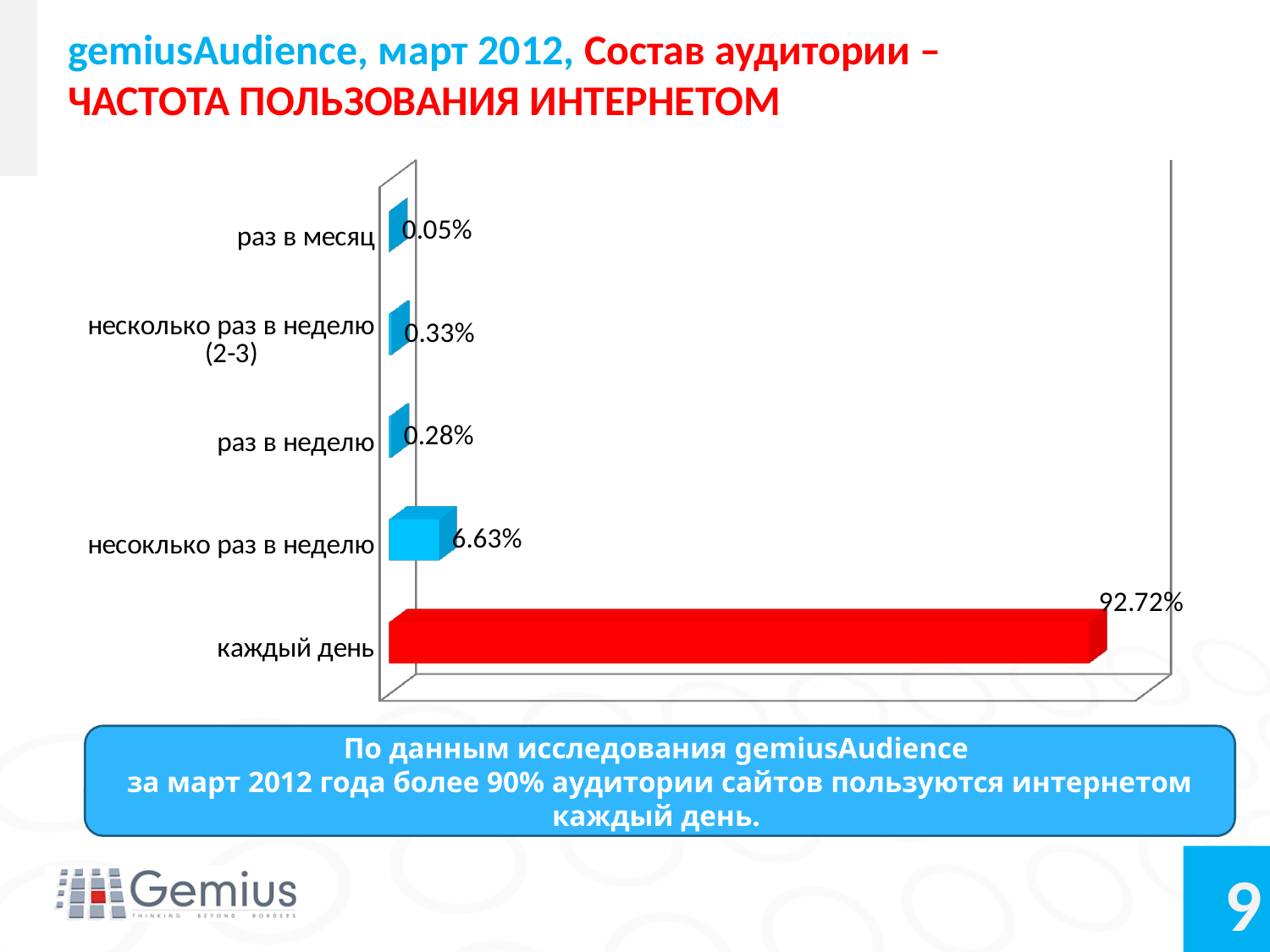
Which category has the lowest value? раз в месяц What is the value for "несоколько раз в неделю"? 6.63% What is the value for "раз в неделю"? 0.28% What is the value for "раз в месяц"? 0.05% Which is larger, the value for "несколько раз в неделю (2-3)" or the value for "раз в неделю"? несколько раз в неделю (2-3) What is the difference between the values for "каждый день" and "несоколько раз в неделю"? 86.09% How many categories are shown in the chart? 5 What colour is the bar for "каждый день"? red What kind of chart is shown on the slide? bar chart What is the value for "каждый день"? 92.72% Which category has the highest value? каждый день What is the value for "несколько раз в неделю (2-3)"? 0.33%